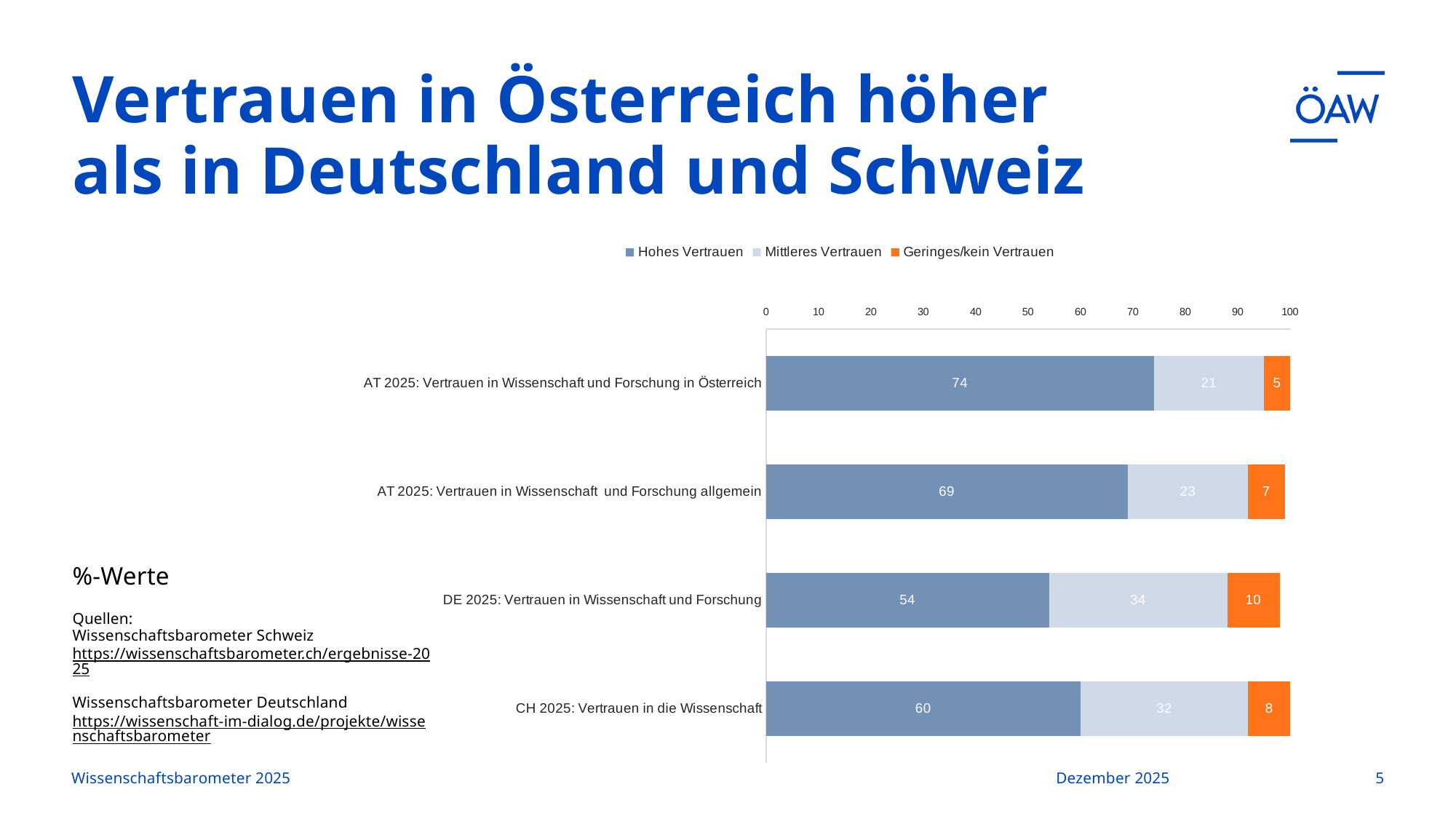
How many series does the legend list? 3 Which category has the highest "Hohes Vertrauen" value? AT 2025: Vertrauen in Wissenschaft und Forschung in Österreich Which series is shown in orange in the chart? Geringes/kein Vertrauen How many categories are shown in the chart? 4 What is the difference between the "Hohes Vertrauen" values for "AT 2025: Vertrauen in Wissenschaft und Forschung in Österreich" and "DE 2025: Vertrauen in Wissenschaft und Forschung"? 20 What kind of chart is shown on the slide? Stacked bar chart Which category has the lowest "Hohes Vertrauen" value? DE 2025: Vertrauen in Wissenschaft und Forschung What is the total of the stacked bar for "AT 2025: Vertrauen in Wissenschaft und Forschung allgemein"? 99 Which is larger: the "Geringes/kein Vertrauen" value for "DE 2025: Vertrauen in Wissenschaft und Forschung" or for "CH 2025: Vertrauen in die Wissenschaft"? DE 2025: Vertrauen in Wissenschaft und Forschung What is the "Hohes Vertrauen" value for "AT 2025: Vertrauen in Wissenschaft und Forschung in Österreich"? 74 What is the "Geringes/kein Vertrauen" value for "CH 2025: Vertrauen in die Wissenschaft"? 8 What is the "Mittleres Vertrauen" value for "DE 2025: Vertrauen in Wissenschaft und Forschung"? 34